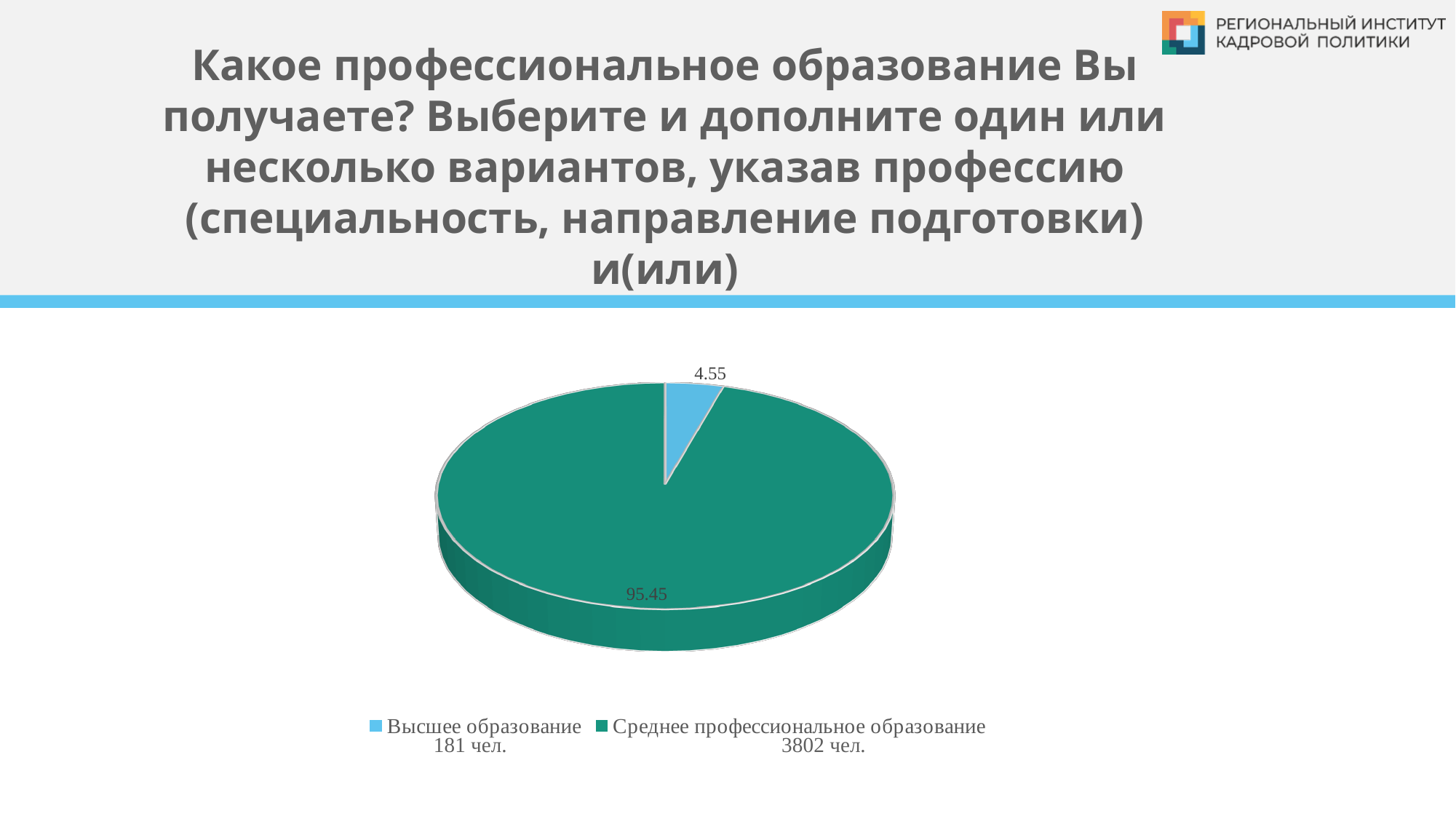
Which is larger: the slice for Высшее образование or the slice for Среднее профессиональное образование? Среднее профессиональное образование Which category has the smallest slice of the pie? Высшее образование How many people (чел.) are shown in the legend for Среднее профессиональное образование? 3802 чел. What kind of chart is shown on the slide? pie chart What is the value shown for Среднее профессиональное образование? 95.45 Which category has the largest slice of the pie? Среднее профессиональное образование How many people (чел.) are shown in the legend for Высшее образование? 181 чел. What is the value shown for Высшее образование? 4.55 What is the difference between the values for Среднее профессиональное образование and Высшее образование? 90.9 How many entries does the legend list? 2 How many slices does the pie chart have? 2 What colour is the slice for Высшее образование? light blue